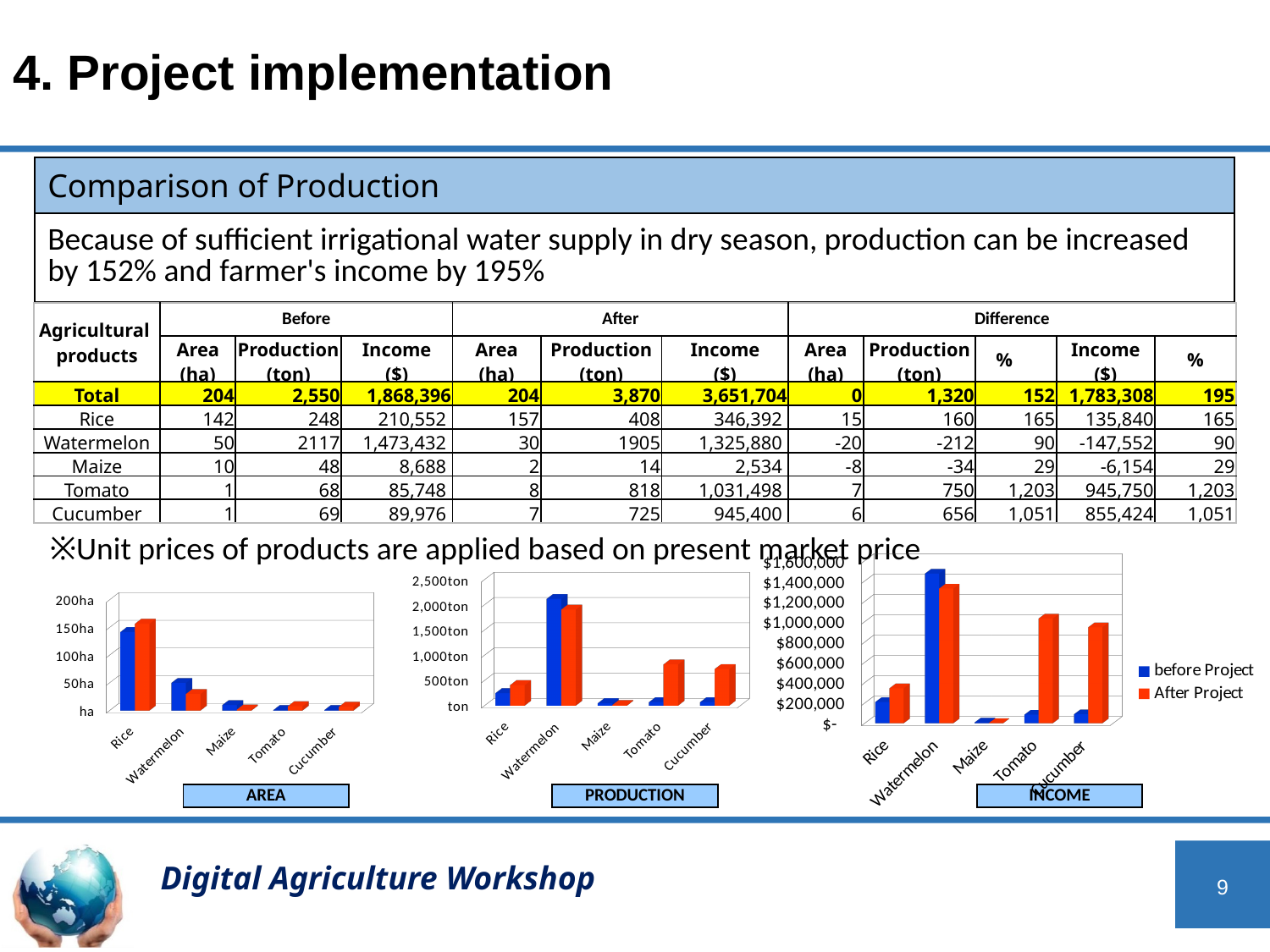
In the AREA chart, is the After Project value for Rice greater or less than 150ha? greater How many categories are shown on the PRODUCTION chart? 5 In the INCOME chart, is the After Project value for Rice greater or less than $400,000? less In the AREA chart, is the After Project value for Watermelon greater or less than 50ha? less In the INCOME chart, which is larger for Rice: the before Project value or the After Project value? After Project In the PRODUCTION chart, which category has the highest After Project value? Watermelon What kind of chart is the AREA chart? bar chart How many series does the legend list for the charts? 2 In the AREA chart, which category has the highest before Project value? Rice In the INCOME chart, which category has the highest before Project value? Watermelon